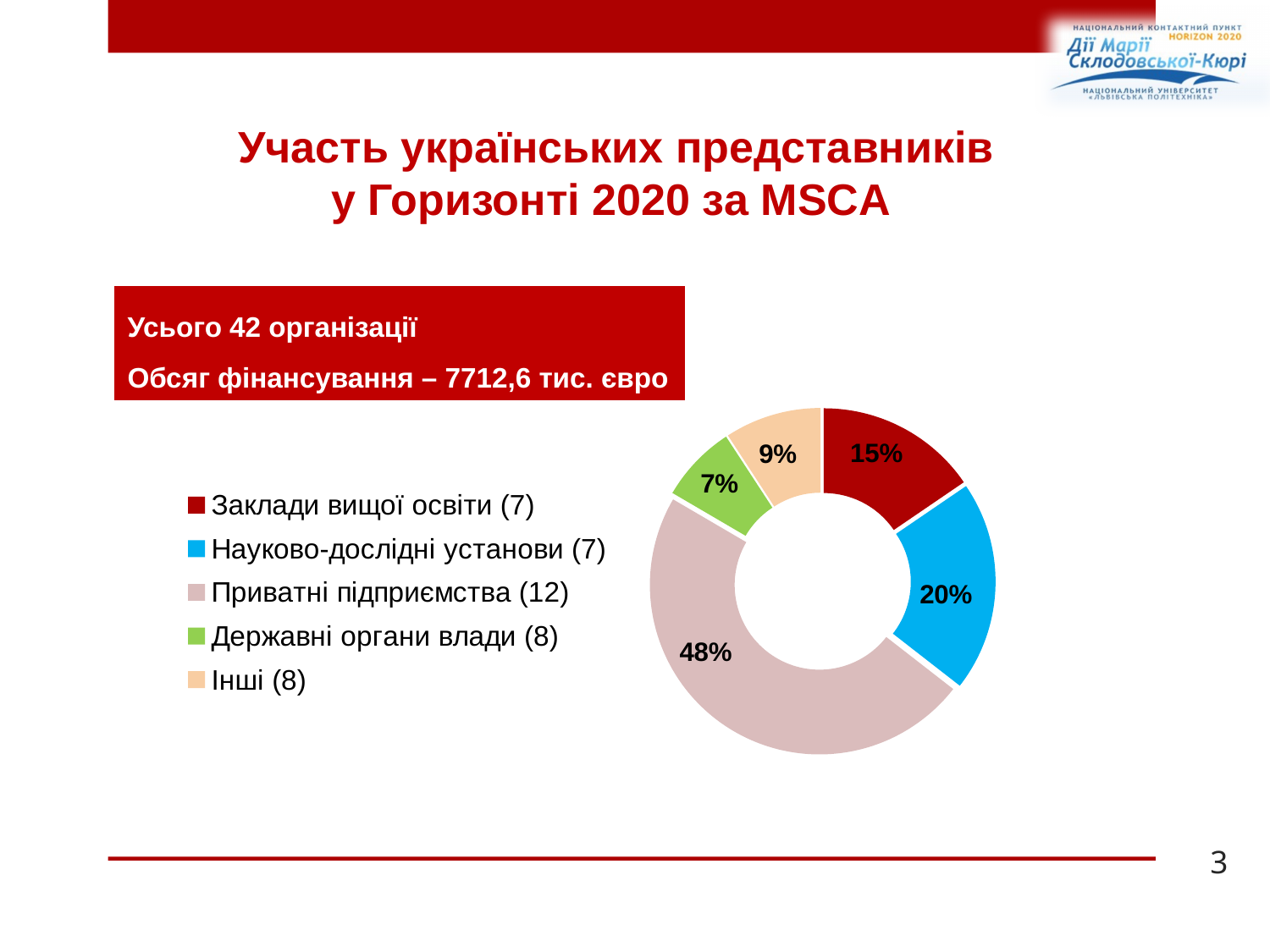
What percentage is shown for Науково-дослідні установи (7)? 20% What percentage is shown for Заклади вищої освіти (7)? 15% What percentage is shown for Інші (8)? 9% What colour is the slice for Науково-дослідні установи (7)? Blue Which category has the smallest share of the chart? Державні органи влади (8) How many categories does the chart show? 5 What kind of chart is shown on the slide? Doughnut chart Which category has the largest share of the chart? Приватні підприємства (12) Which is larger, the share for Інші (8) or the share for Державні органи влади (8)? Інші (8) What is the difference in percentage points between Приватні підприємства (12) and Науково-дослідні установи (7)? 28% What percentage is shown for Приватні підприємства (12)? 48% What percentage is shown for Державні органи влади (8)? 7%